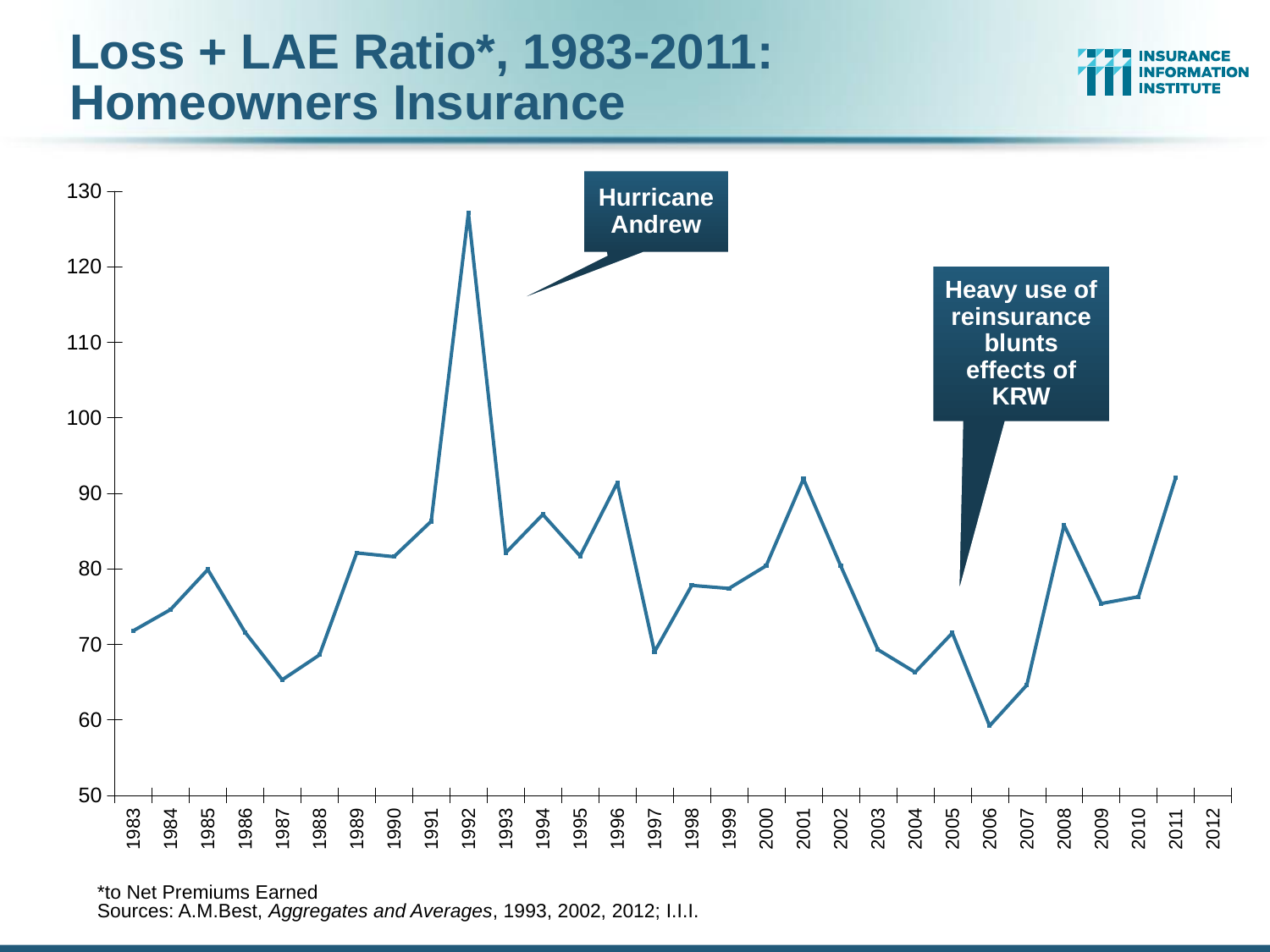
Does the Loss + LAE ratio rise or fall from 2009 to 2011? rise Which year has the larger Loss + LAE ratio, 2008 or 2009? 2008 Is the value for 2003 greater or less than 80? less Is the value for 1992 greater or less than 120? greater Which year has the larger Loss + LAE ratio, 1992 or 2001? 1992 Is the value for 2006 greater or less than 70? less Which year has the lowest Loss + LAE ratio? 2006 Which year has the highest Loss + LAE ratio? 1992 Which event does the callout pointing to the 1992 peak name? Hurricane Andrew What kind of chart is shown on the slide? line chart